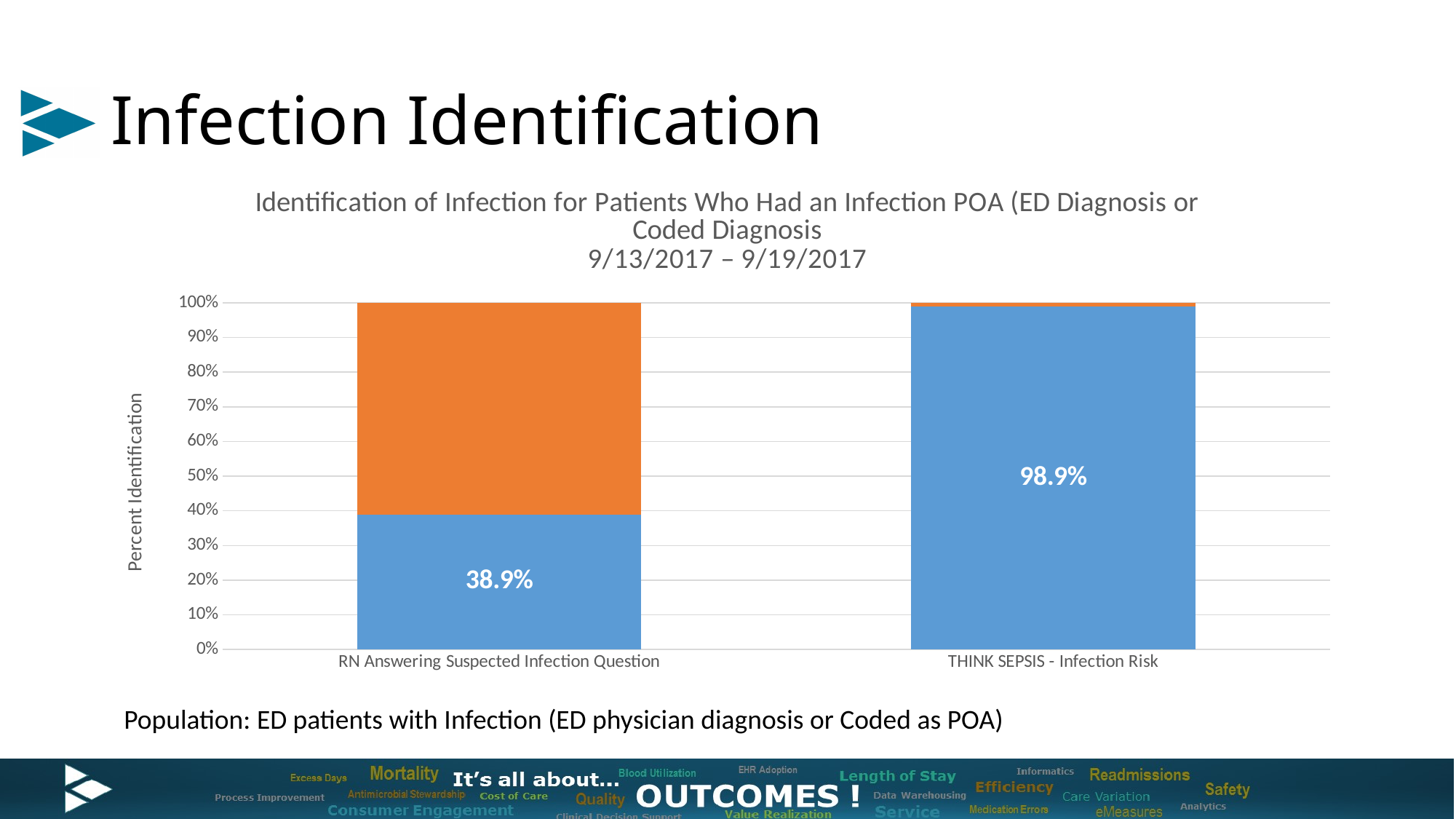
What is the value of the blue segment for THINK SEPSIS - Infection Risk? 98.9% What is the difference between the blue-segment values for THINK SEPSIS - Infection Risk and RN Answering Suspected Infection Question? 60.0 percentage points What is the total height of the stacked bar for RN Answering Suspected Infection Question? 100% Is the blue-segment value for RN Answering Suspected Infection Question greater or less than 50%? less Which category has the lower blue-segment value? RN Answering Suspected Infection Question What is the value of the blue segment for RN Answering Suspected Infection Question? 38.9% Is the orange segment for RN Answering Suspected Infection Question greater or less than 50%? greater What is the label on the y axis of the chart? Percent Identification How many categories are shown on the x axis? 2 What kind of chart is shown on the slide? Stacked bar chart Which category has the higher blue-segment value? THINK SEPSIS - Infection Risk Is the blue-segment value for RN Answering Suspected Infection Question larger or smaller than that for THINK SEPSIS - Infection Risk? smaller